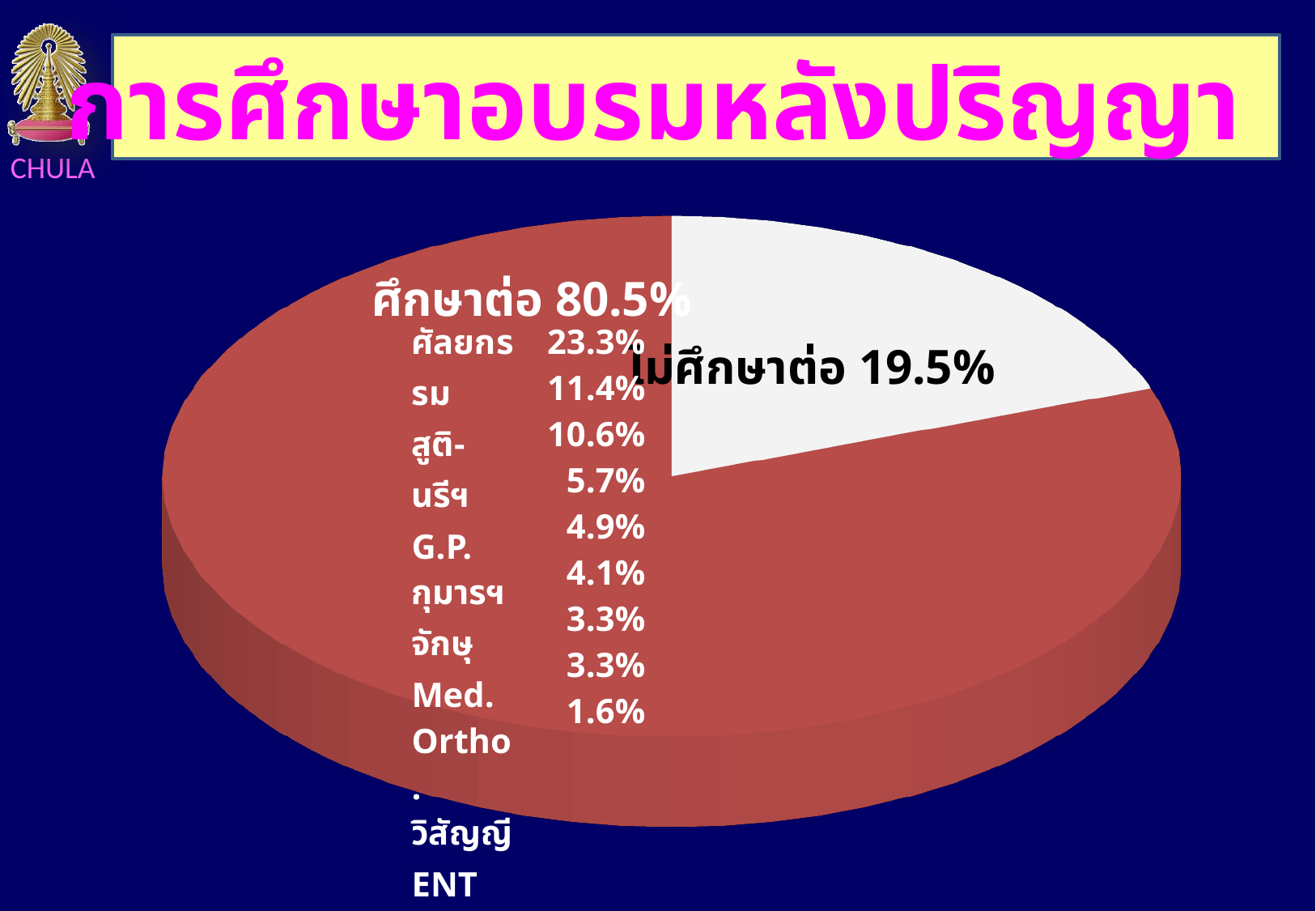
Is the value for ไม่ศึกษาต่อ greater or less than 25%? less Which is larger, the ศึกษาต่อ slice or the ไม่ศึกษาต่อ slice? ศึกษาต่อ What kind of chart is shown on the slide? pie chart What is the difference in percentage points between the ศึกษาต่อ and ไม่ศึกษาต่อ slices? 61% Which slice of the pie is the smallest? ไม่ศึกษาต่อ What percentage is listed for ENT in the breakdown of the ศึกษาต่อ slice? 1.6% Which slice of the pie is the largest? ศึกษาต่อ What colour is the ศึกษาต่อ slice of the pie? red What percentage does the ไม่ศึกษาต่อ slice represent? 19.5% What percentage does the ศึกษาต่อ slice represent? 80.5% How many slices does the pie chart have? 2 What is the title of the slide containing the pie chart? การศึกษาอบรมหลังปริญญา